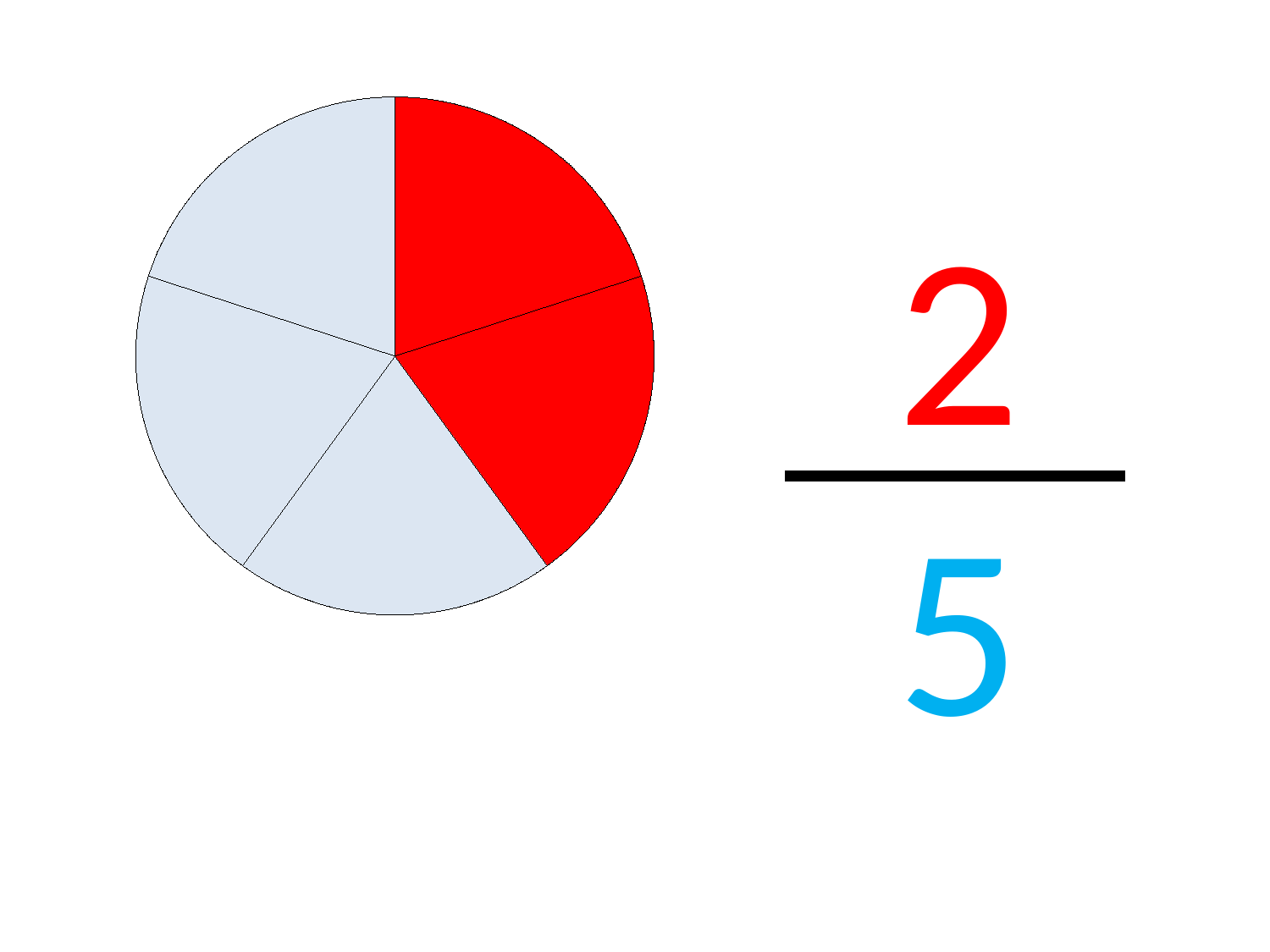
How many slices of the pie chart are coloured red? 2 Are the slices of the pie chart equal in size? yes How many slices of the pie chart are coloured light blue? 3 What fraction of the pie chart is shaded red, as written on the slide? 2/5 Which colour covers more of the pie chart, red or light blue? light blue What fraction is written to the right of the pie chart? 2/5 What kind of chart is shown on the slide? pie chart How many slices is the pie chart divided into? 5